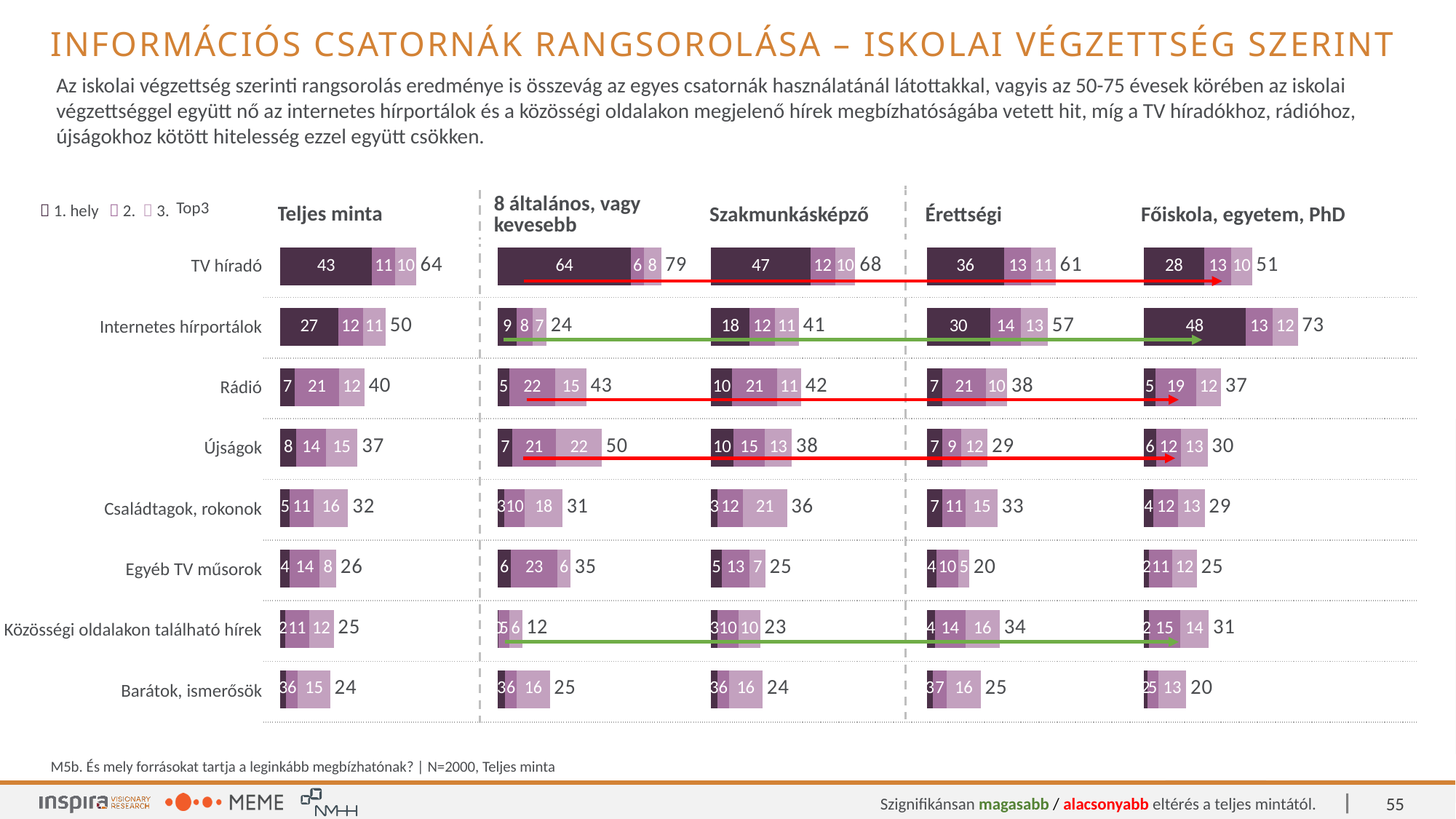
In the Teljes minta chart, what is the difference between the Top3 values for TV híradó and Internetes hírportálok? 14 How many categories (information channels) are listed in each chart? 8 In the Szakmunkásképző chart, what is the Top3 total for Rádió? 42 What kind of chart is used on this slide? Stacked bar chart Across the four education-level charts from left to right (8 általános to Főiskola), does the Top3 value for TV híradó rise or fall? Fall In the Teljes minta chart, what is the 1. hely value for TV híradó? 43 How many ranking series does the legend list (excluding the Top3 total)? 3 In the Érettségi chart, which has the larger Top3 value: TV híradó or Internetes hírportálok? TV híradó In the Főiskola, egyetem, PhD chart, what is the Top3 value for Internetes hírportálok? 73 In the Főiskola, egyetem, PhD chart, which category has the lowest Top3 value? Barátok, ismerősök In the Szakmunkásképző chart, what is the 2. value for Újságok? 15 In the 8 általános, vagy kevesebb chart, which category has the highest Top3 value? TV híradó